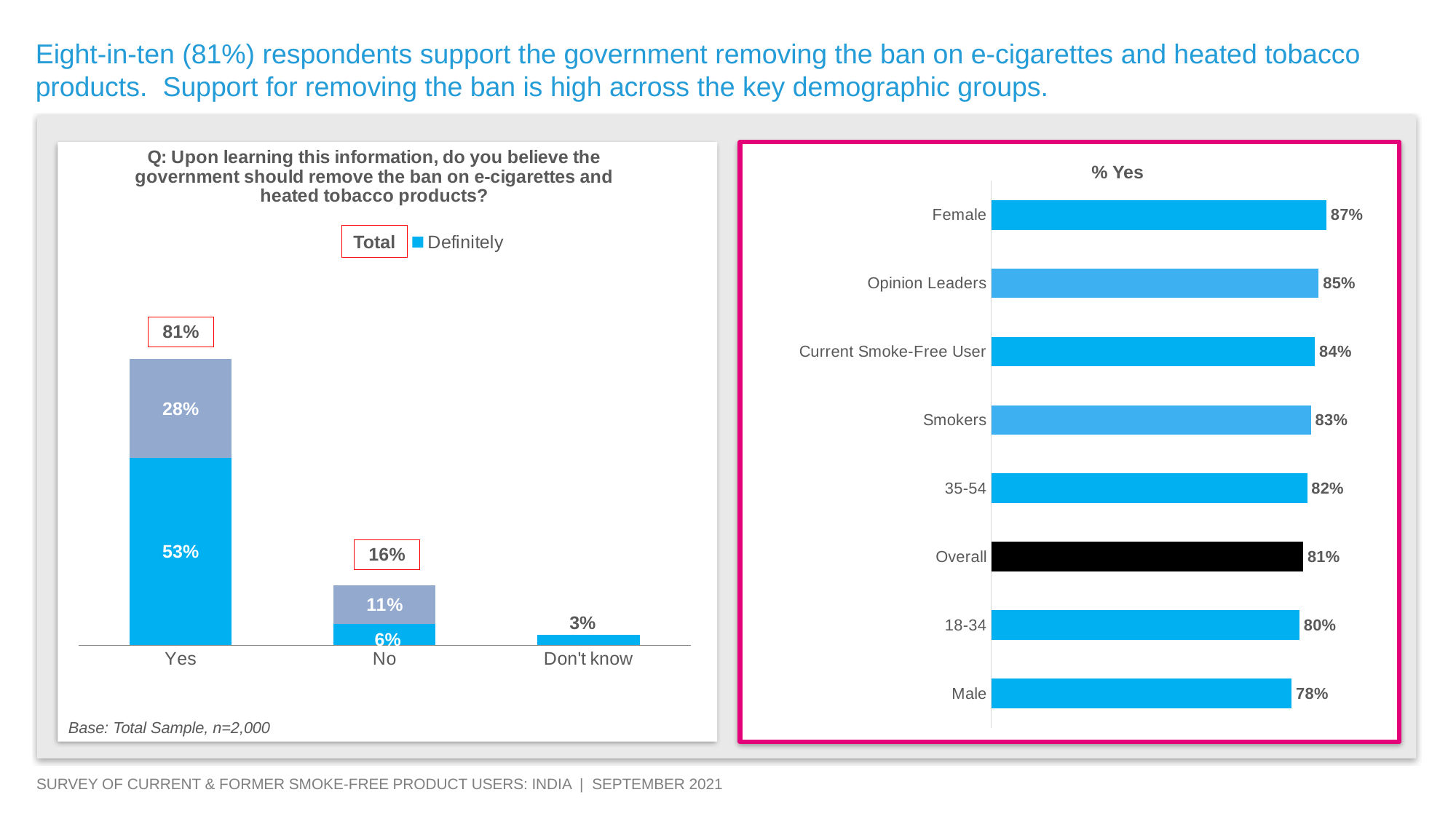
In the left chart, how many categories are shown on the x axis? 3 In the '% Yes' chart, which is larger, Smokers or 18-34? Smokers In the '% Yes' chart, what is the value for Opinion Leaders? 85% In the left chart, what is the total for the Yes bar? 81% In the '% Yes' chart, what is the difference between Female and Male? 9% In the '% Yes' chart, how many categories are shown? 8 In the '% Yes' chart, which category has the highest value? Female In the left chart, what is the total for the No bar? 16% What kind of chart is the '% Yes' chart? Bar chart In the '% Yes' chart, which category has the lowest value? Male In the left chart, what is the 'Definitely' value for Yes? 53% In the left chart, what is the value for Don't know? 3%